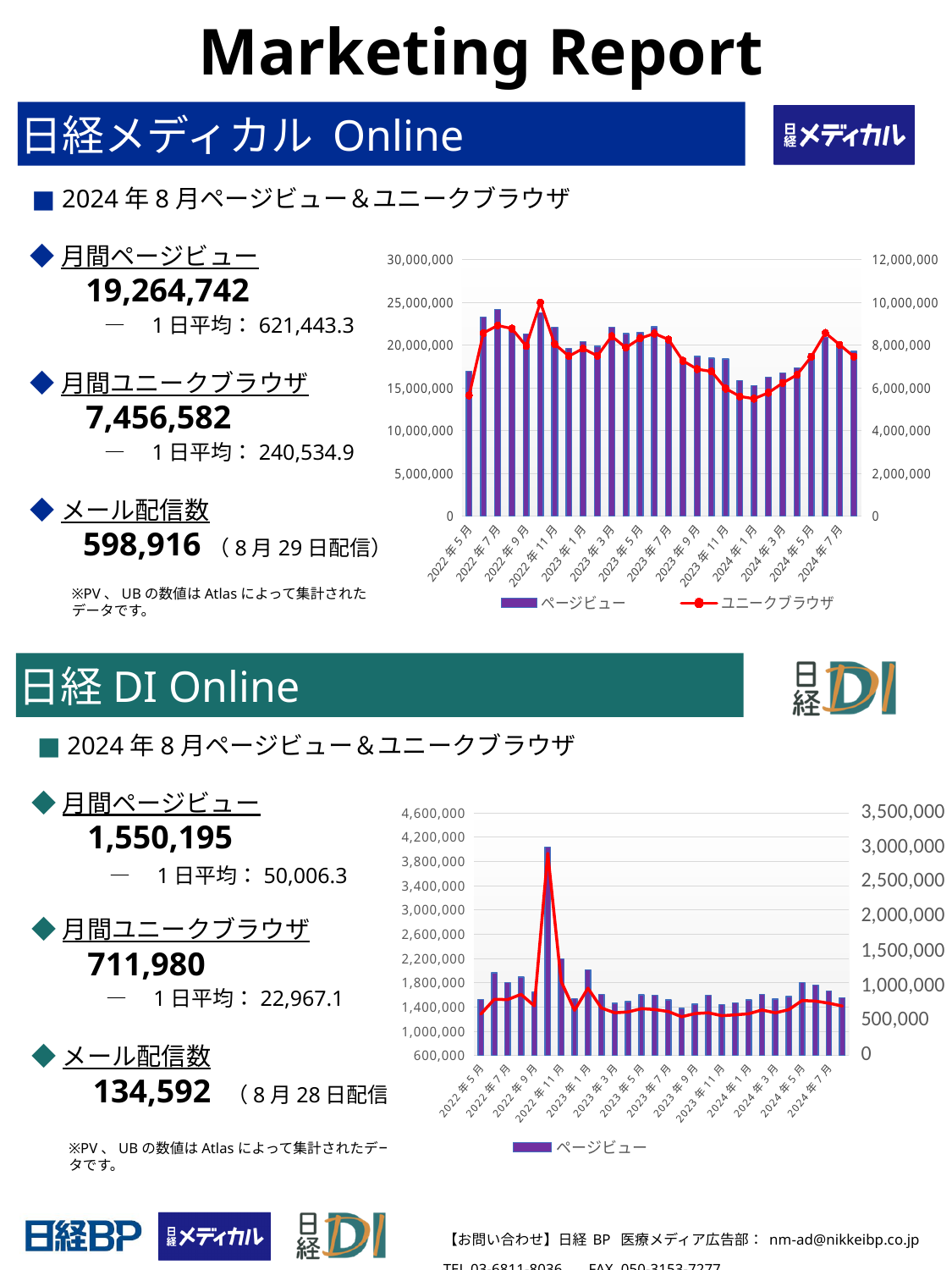
In the 日経メディカル Online chart, is the ページビュー value for 2022年5月 greater or less than 20,000,000? less In the 日経 DI Online chart, which month has the highest ページビュー bar? 2022年10月 In the 日経メディカル Online chart, is the ページビュー value for 2024年1月 greater or less than 20,000,000? less In the 日経メディカル Online chart, do the ページビュー bars rise or fall from 2023年7月 to 2024年1月? fall How many series does the legend of the 日経 DI Online chart list? 1 How many series does the legend of the 日経メディカル Online chart list? 2 In the 日経 DI Online chart, is the ページビュー value for 2023年3月 greater or less than 1,800,000? less In the 日経メディカル Online chart, which series is drawn as a red line? ユニークブラウザ What kind of chart is shown in the 日経メディカル Online section? A combined bar and line chart In the 日経メディカル Online chart, in which month does the ユニークブラウザ line reach its highest point? 2022年10月